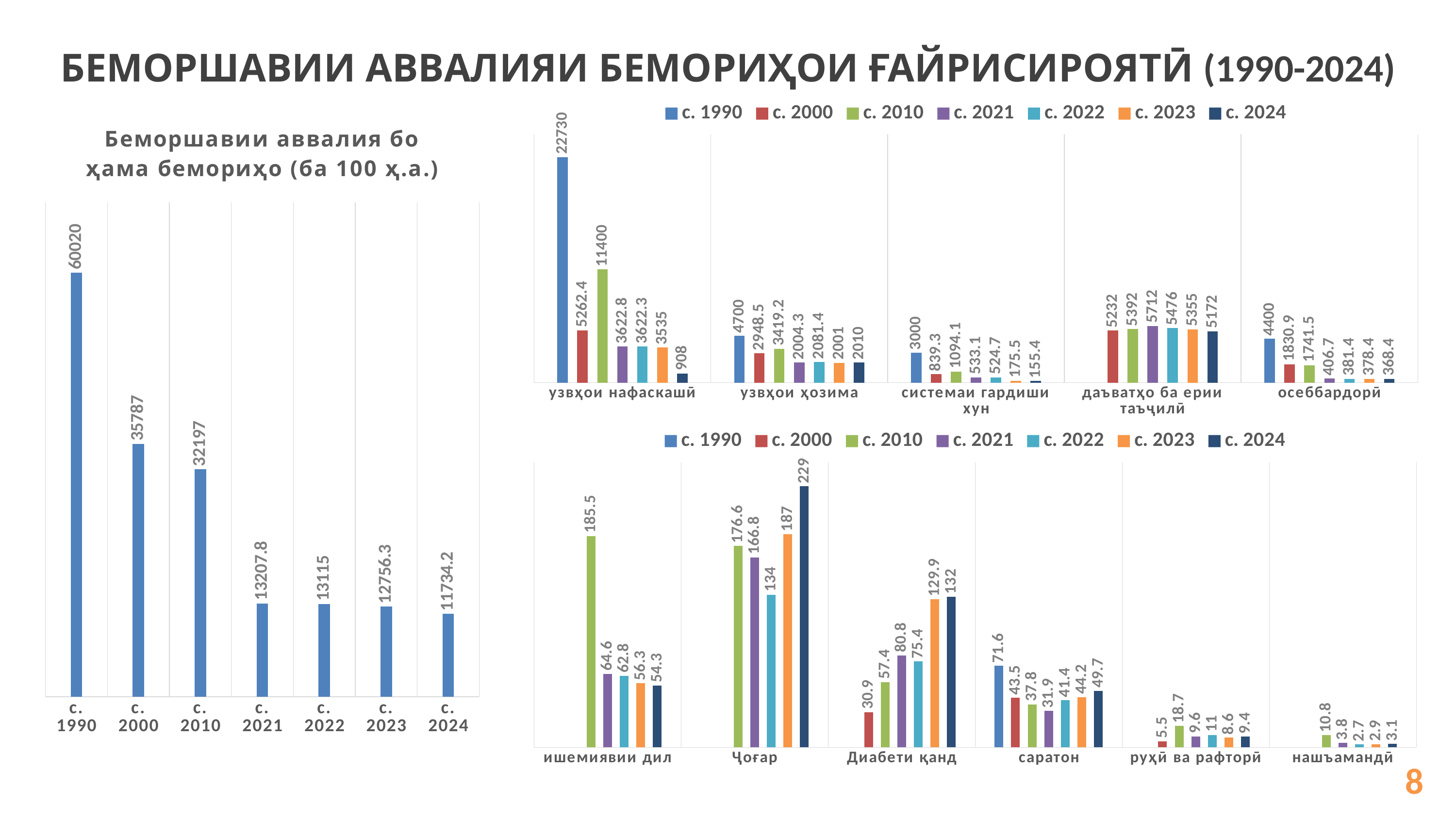
In the left chart titled 'Беморшавии аввалия бо ҳама бемориҳо (ба 100 ҳ.а.)', which year has the lowest value? с. 2024 In the top-right chart, how many series does the legend list? 7 In the bottom-right chart, what is the difference between the с. 2023 and с. 2024 values in the category 'Диабети қанд'? 2.1 In the bottom-right chart, what is the value for с. 2024 in the category 'Ҷоғар'? 229 In the bottom-right chart, how many categories are shown on the x axis? 6 In the left chart titled 'Беморшавии аввалия бо ҳама бемориҳо (ба 100 ҳ.а.)', do the values rise or fall from с. 1990 to с. 2024? fall In the left chart titled 'Беморшавии аввалия бо ҳама бемориҳо (ба 100 ҳ.а.)', what is the value for с. 1990? 60020 In the top-right chart, what is the value for с. 2024 in the category 'узвҳои нафаскашӣ'? 908 In the top-right chart, which series has the highest value in the category 'даъватҳо ба ерии таъҷилӣ'? с. 2021 In the left chart titled 'Беморшавии аввалия бо ҳама бемориҳо (ба 100 ҳ.а.)', what is the difference between the values for с. 2000 and с. 2010? 3590 In the top-right chart, which is larger in the category 'системаи гардиши хун': с. 2000 or с. 2010? с. 2010 What type of chart is the left chart titled 'Беморшавии аввалия бо ҳама бемориҳо (ба 100 ҳ.а.)'? bar chart